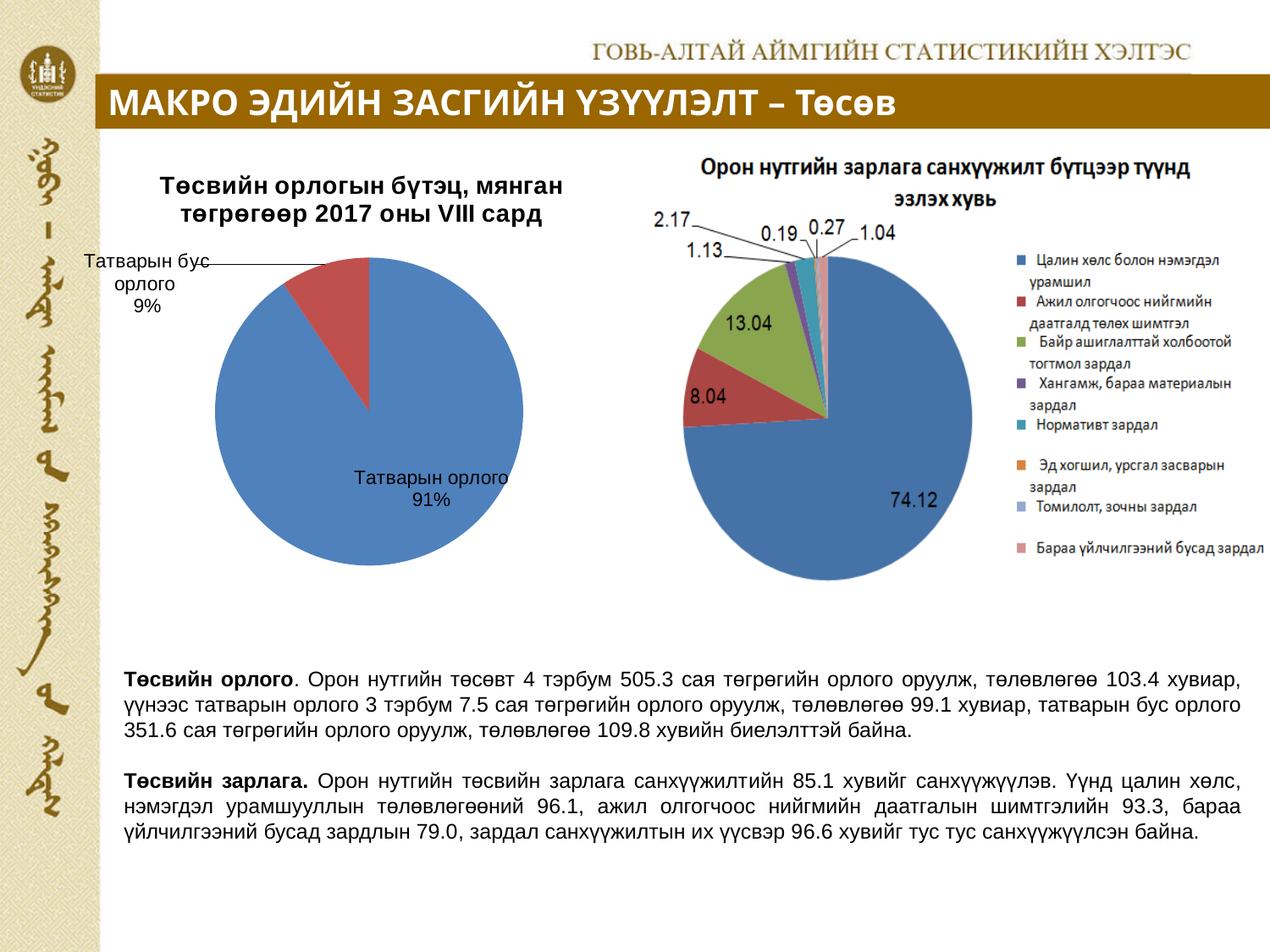
How many slices does the left pie chart have? 2 In the left pie chart, what share does 'Татварын орлого' have? 91% In the right pie chart, what is the value for 'Байр ашиглалттай холбоотой тогтмол зардал'? 13.04 In the right chart titled 'Орон нутгийн зарлага санхүүжилт бүтцээр түүнд эзлэх хувь', what is the value of the largest slice? 74.12 In the left pie chart, which slice is the largest? Татварын орлого In the left pie chart, what is the difference in percentage points between 'Татварын орлого' and 'Татварын бус орлого'? 82 How many categories does the legend of the right pie chart list? 8 What kind of chart is the left chart titled 'Төсвийн орлогын бүтэц, мянган төгрөгөөр 2017 оны VIII сард'? Pie chart In the right pie chart, which category has the largest share? Цалин хөлс болон нэмэгдэл урамшил In the right pie chart, what is the smallest value shown on any slice? 0.19 In the right pie chart, what is the value for 'Ажил олгогчоос нийгмийн даатгалд төлөх шимтгэл'? 8.04 In the left pie chart, what share does 'Татварын бус орлого' have? 9%